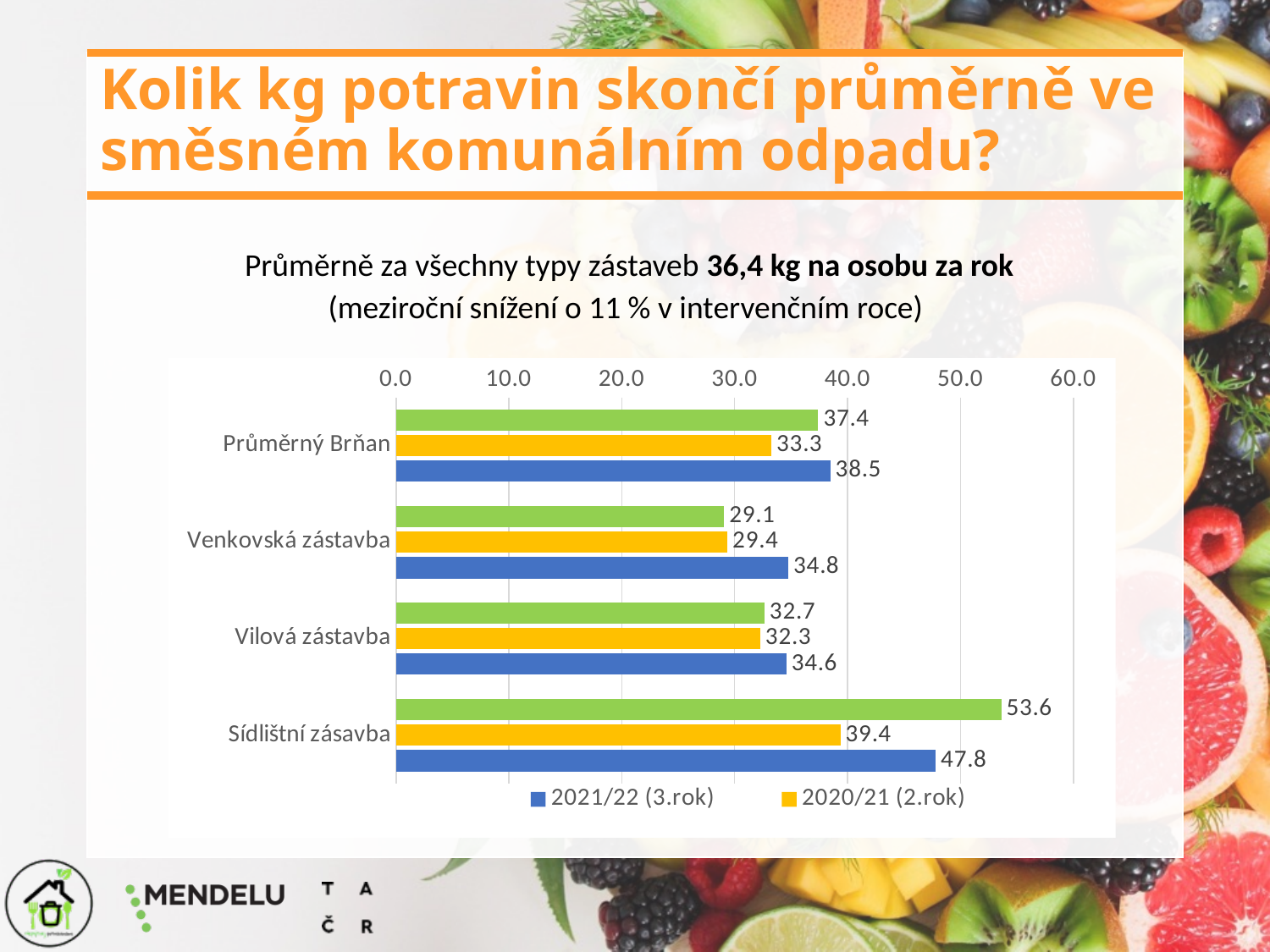
For Průměrný Brňan, how much larger is the 2021/22 (3.rok) value than the 2020/21 (2.rok) value? 5.2 Which category has the lowest value in the 2020/21 (2.rok) series? Venkovská zástavba What is the value for Sídlištní zásavba in the 2021/22 (3.rok) series? 47.8 Is the 2021/22 (3.rok) value for Sídlištní zásavba greater or less than 40.0? greater How many categories are shown on the chart? 4 What is the 2021/22 (3.rok) value for Průměrný Brňan? 38.5 For Sídlištní zásavba, what is the difference between the 2021/22 (3.rok) value and the 2020/21 (2.rok) value? 8.4 Which category has the highest value in the 2021/22 (3.rok) series? Sídlištní zásavba What is the value for Venkovská zástavba in the 2020/21 (2.rok) series? 29.4 For Vilová zástavba, which series has the larger value: 2021/22 (3.rok) or 2020/21 (2.rok)? 2021/22 (3.rok) How many series does the legend list? 2 What kind of chart is shown on the slide? bar chart